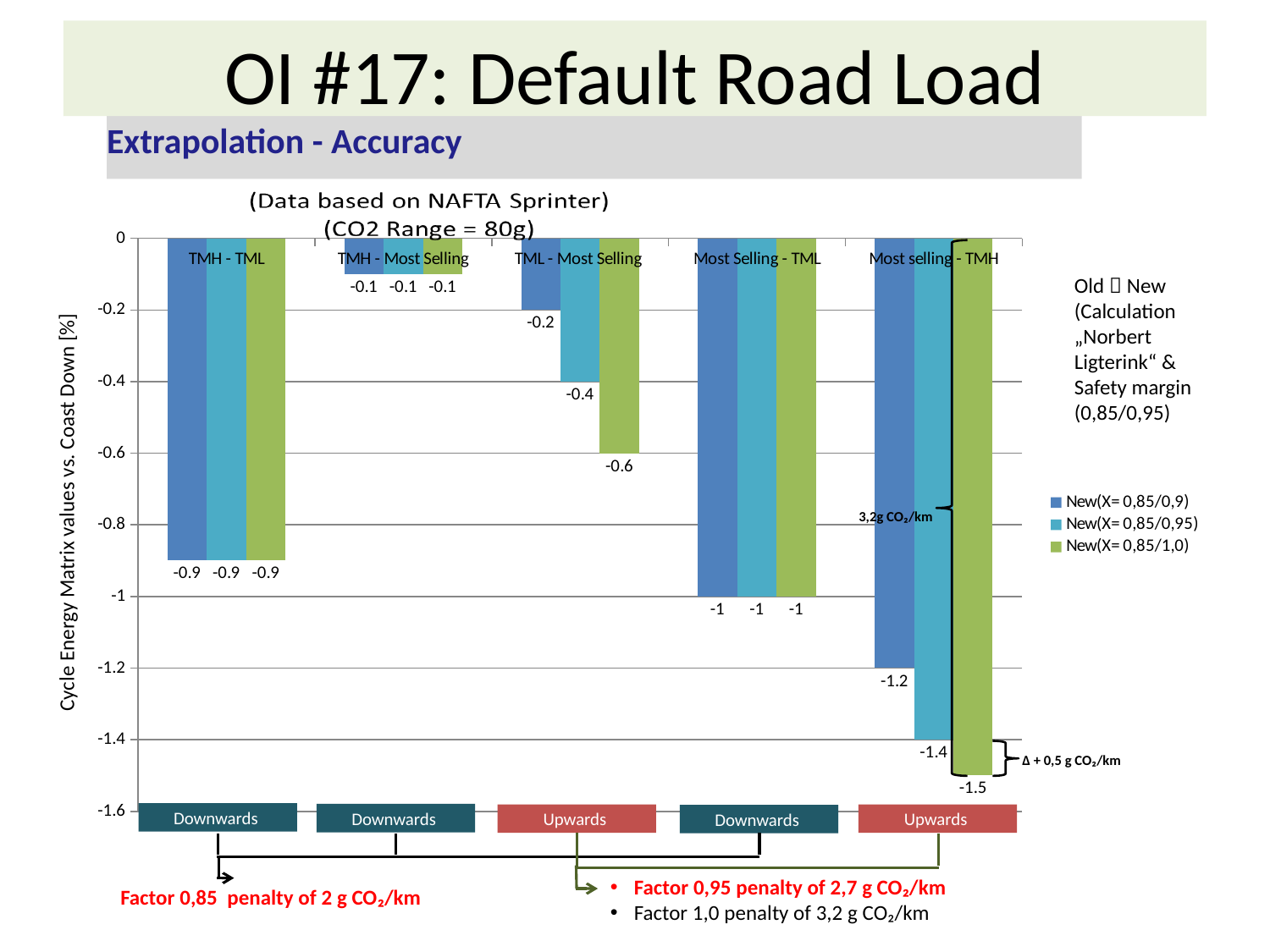
What is the value of the New(X=0,85/0,9) series for the category TMH - TML? -0.9 Which category has the value closest to zero for the New(X=0,85/0,95) series? TMH - Most Selling What label is shown on the y axis of the chart? Cycle Energy Matrix values vs. Coast Down [%] What is the difference between the New(X=0,85/1,0) value and the New(X=0,85/0,9) value for the category TML - Most Selling? 0.4 What is the value of the New(X=0,85/0,95) series for the category Most selling - TMH? -1.4 How many series does the chart legend list? 3 What is the value of the New(X=0,85/1,0) series for the category Most selling - TMH? -1.5 What is the value of the New(X=0,85/0,9) series for the category TML - Most Selling? -0.2 For the category Most selling - TMH, which series has the more negative value: New(X=0,85/0,9) or New(X=0,85/0,95)? New(X=0,85/0,95) What type of chart is shown on the slide? bar chart How many categories are plotted along the x axis of the chart? 5 Which category has the lowest (most negative) value for the New(X=0,85/1,0) series? Most selling - TMH